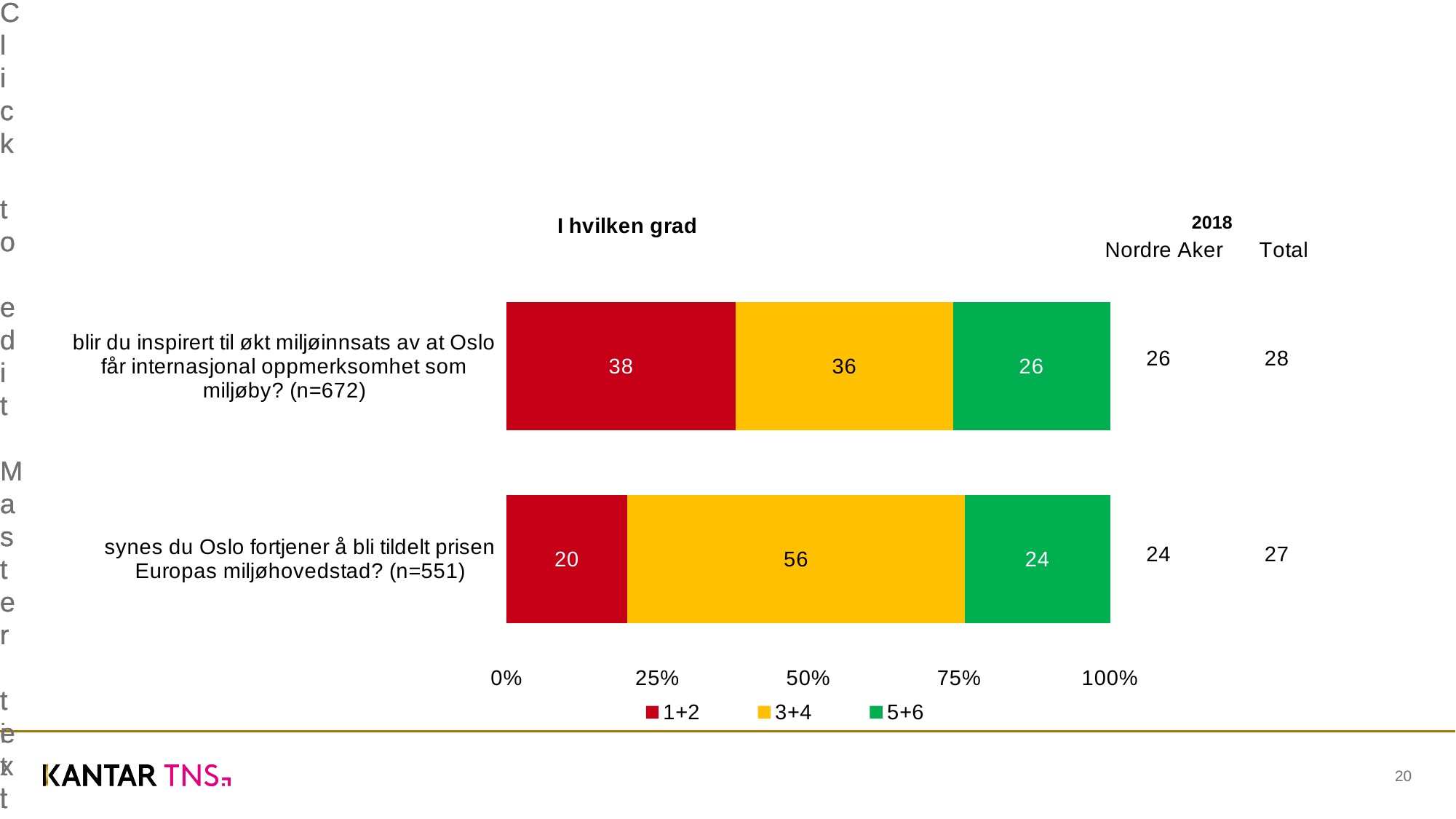
What kind of chart is shown on the slide? Stacked bar chart What is the value of the 5+6 series for the question 'blir du inspirert til økt miljøinnsats av at Oslo får internasjonal oppmerksomhet som miljøby? (n=672)'? 26 Which is larger: the 5+6 value for 'blir du inspirert til økt miljøinnsats...' or the 5+6 value for 'synes du Oslo fortjener...'? blir du inspirert til økt miljøinnsats av at Oslo får internasjonal oppmerksomhet som miljøby? (n=672) What is the value of the 1+2 series for the question 'blir du inspirert til økt miljøinnsats av at Oslo får internasjonal oppmerksomhet som miljøby? (n=672)'? 38 How many questions (categories) are plotted in the chart? 2 What is the value of the 3+4 series for the question 'synes du Oslo fortjener å bli tildelt prisen Europas miljøhovedstad? (n=551)'? 56 Which of the two questions has the higher value for the 3+4 series? synes du Oslo fortjener å bli tildelt prisen Europas miljøhovedstad? (n=551) What is the value of the 1+2 series for the question 'synes du Oslo fortjener å bli tildelt prisen Europas miljøhovedstad? (n=551)'? 20 What is the difference between the 1+2 values of the two questions? 18 What is the total of the stacked bar for 'synes du Oslo fortjener å bli tildelt prisen Europas miljøhovedstad? (n=551)'? 100 What colour represents the 5+6 series in the chart? Green How many series does the legend list? 3